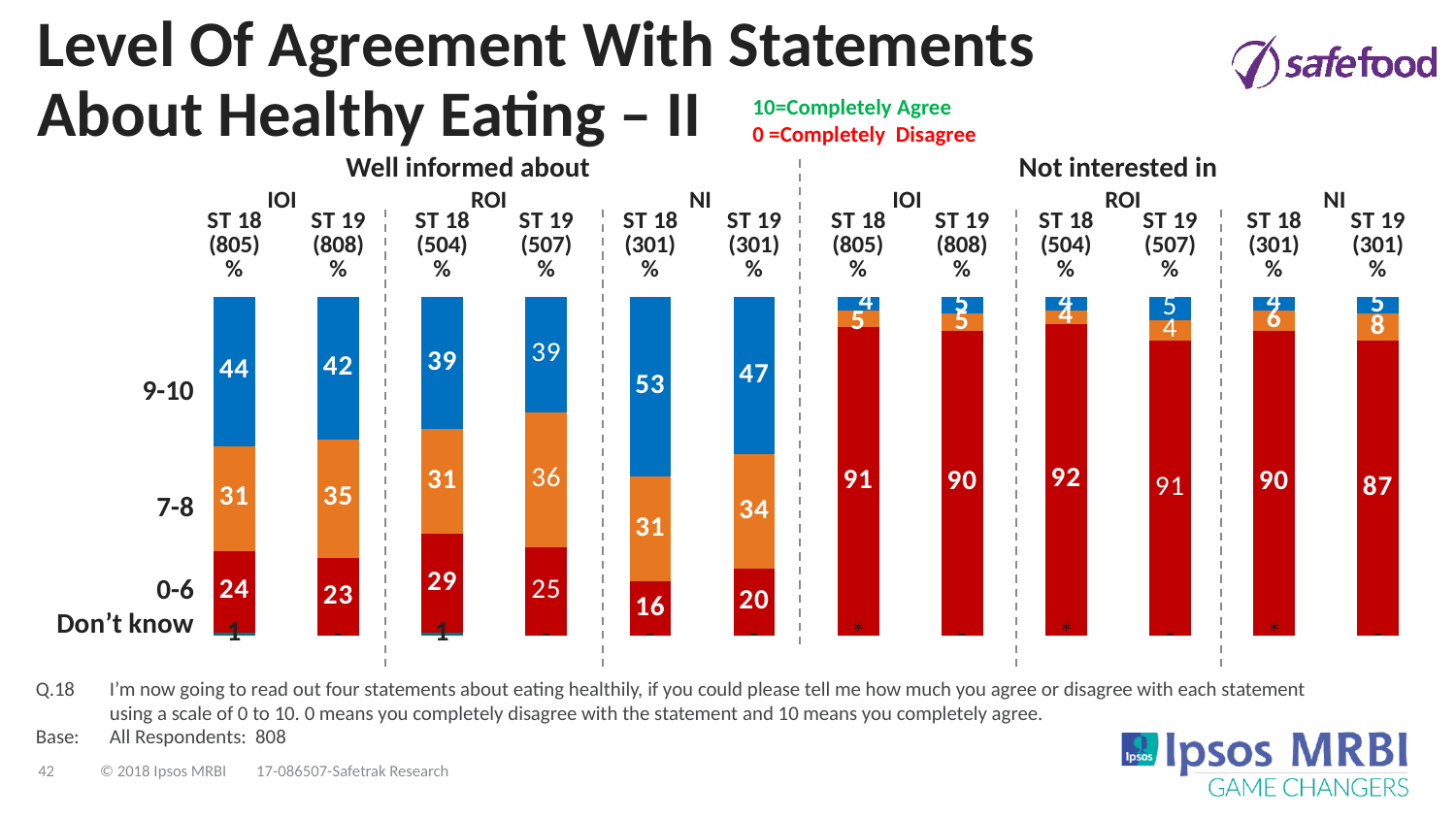
In the 'Well informed about' section, what is the difference between the 9-10 values for NI ST 18 and NI ST 19? 6 In the 'Well informed about' section, which is larger: the 0-6 value for ROI ST 18 or for ROI ST 19? ROI ST 18 In the 'Well informed about' section, what percentage of IOI ST 19 respondents gave a 7-8 rating? 35 In the 'Well informed about' section, what percentage of NI ST 18 respondents gave a 9-10 rating? 53 In the 'Well informed about' section, which bar has the highest 9-10 value? NI ST 18 What is the base (number of respondents) for the ROI ST 19 bar? 507 What kind of chart is shown on the slide? stacked bar chart In the 'Not interested in' section, what percentage of NI ST 19 respondents gave a 7-8 rating? 8 In the 'Not interested in' section, what percentage of ROI ST 18 respondents gave a 0-6 rating? 92 In the 'Well informed about' section, did the 9-10 value for IOI rise or fall from ST 18 to ST 19? fall In the 'Not interested in' section, which bar has the lowest 0-6 value? NI ST 19 How many bars are shown in the 'Not interested in' section? 6